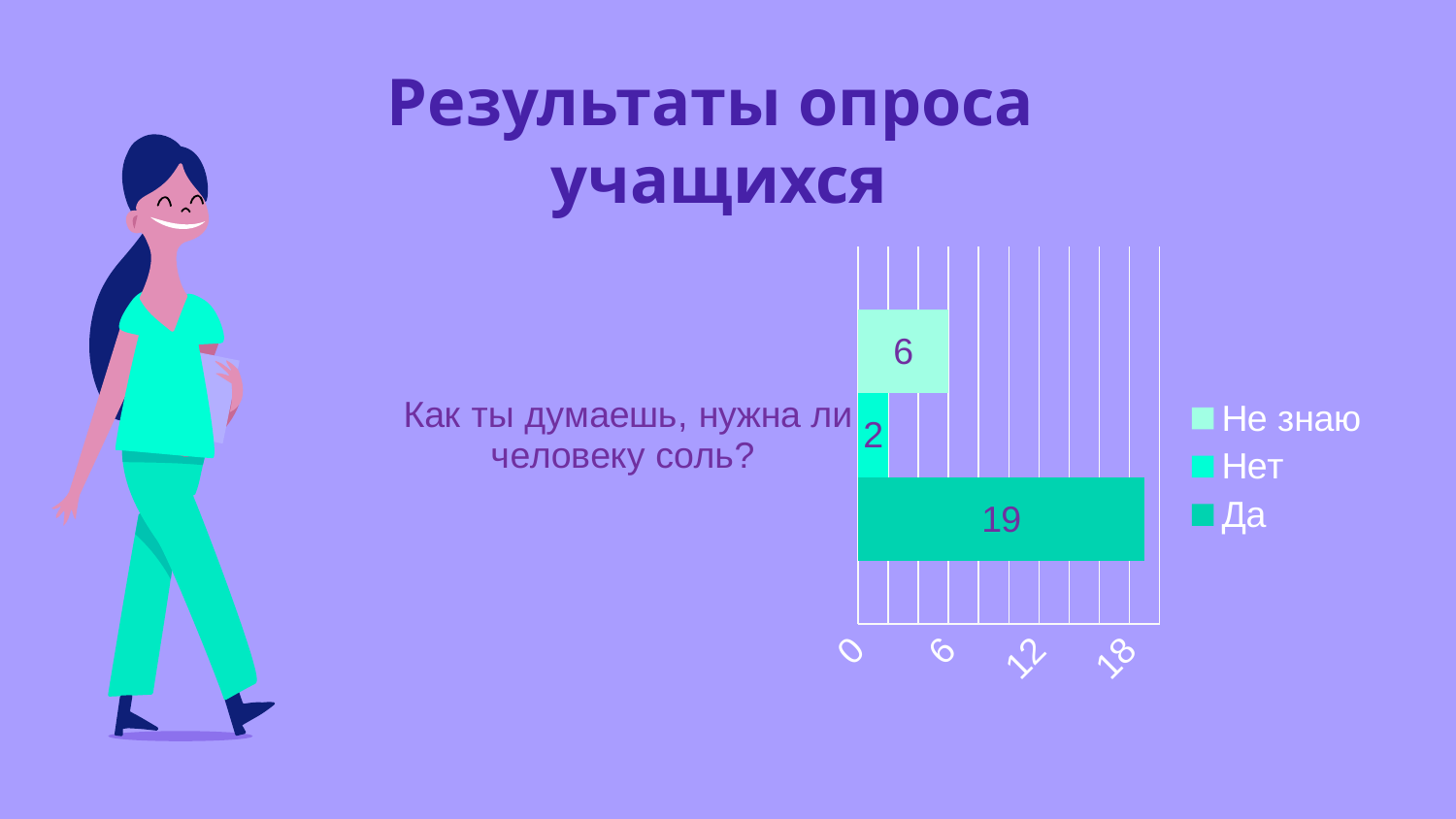
What kind of chart is shown on the slide? bar chart What is the total of all three values shown in the chart? 27 Which series has the highest value in the chart? Да Is the value for "Да" greater or less than 18? greater What value is shown for "Нет" in the chart? 2 How many series does the legend list? 3 What is the difference between the values for "Не знаю" and "Нет"? 4 What value is shown for "Не знаю" in the chart? 6 What value is shown for "Да" in the chart? 19 What is the difference between the values for "Да" and "Не знаю"? 13 Which series has the lowest value in the chart? Нет Which is larger, the value for "Не знаю" or the value for "Нет"? Не знаю